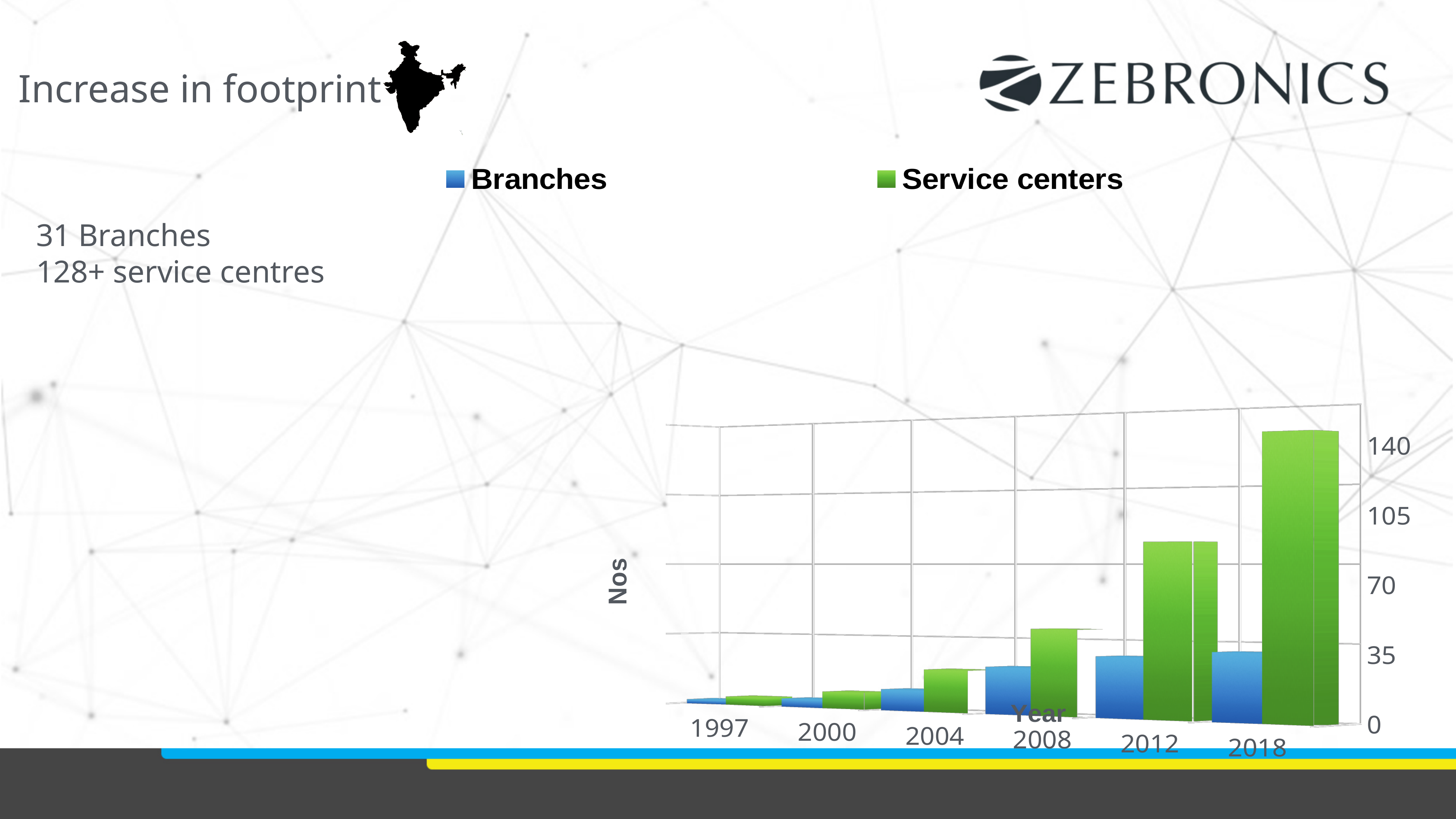
Is the value for Service centers in 2012 greater or less than 70? greater What kind of chart is shown on the slide? bar chart In which year is the Service centers bar highest? 2018 Do the Service centers values rise or fall from 1997 to 2018? rise Is the value for Service centers in 2018 greater or less than 105? greater How many years are shown on the x axis of the chart? 6 In 2018, which is larger: Branches or Service centers? Service centers How many series does the chart's legend list? 2 What colour represents the Branches series in the chart? blue In which year is the Service centers bar lowest? 1997 Is the value for Branches in 2018 greater or less than 70? less